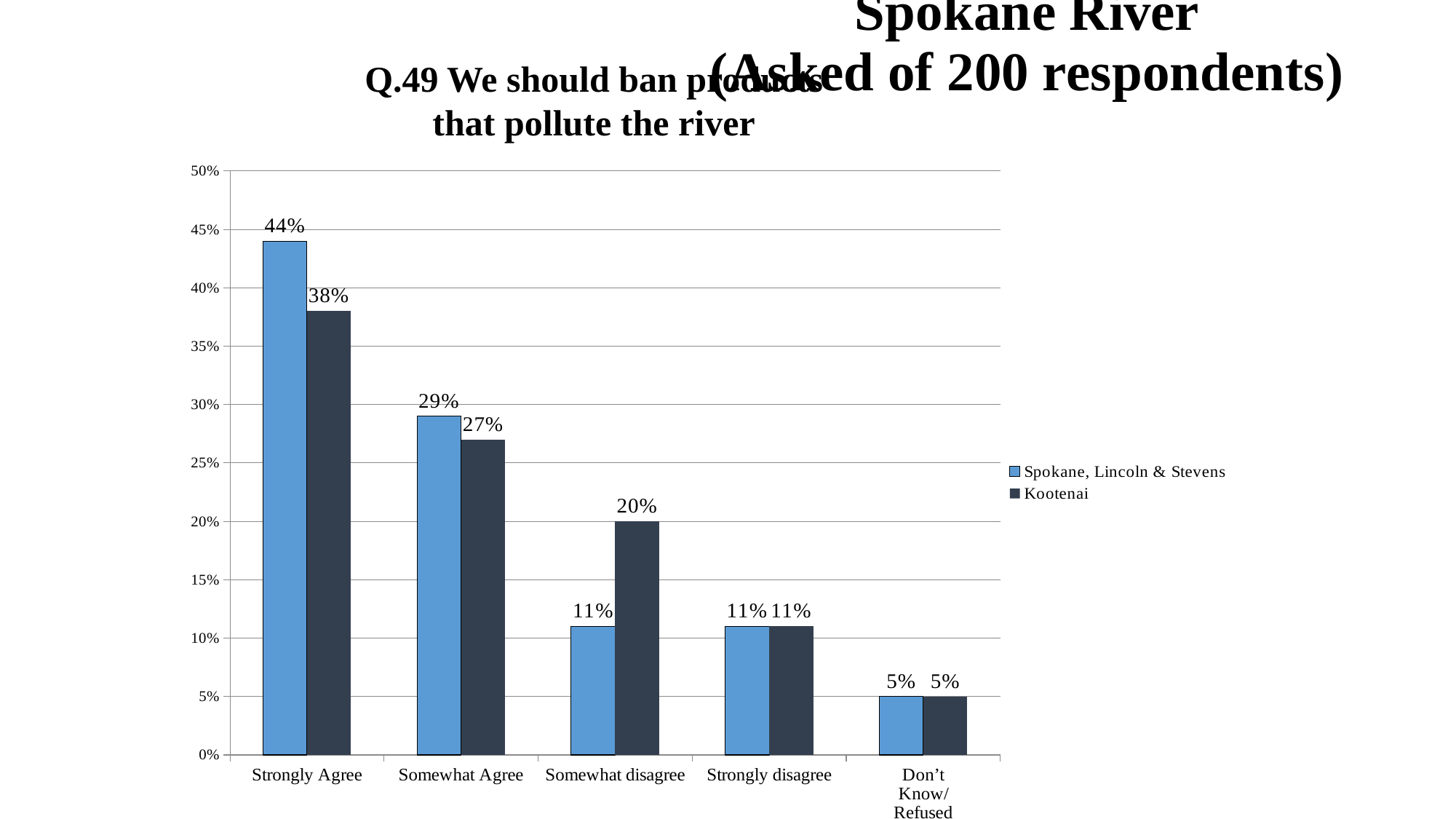
How many categories are shown on the x axis? 5 Do the Spokane, Lincoln & Stevens values rise or fall from Strongly Agree to Don't Know/Refused? Fall What is the value for Kootenai in the Somewhat disagree category? 20% In the Somewhat Agree category, which series has the larger value? Spokane, Lincoln & Stevens What is the value for Spokane, Lincoln & Stevens in the Strongly Agree category? 44% What is the difference between the Spokane, Lincoln & Stevens and Kootenai values in the Strongly Agree category? 6% Which category has the highest value for Kootenai? Strongly Agree How many series does the legend list? 2 What is the difference between the Kootenai and Spokane, Lincoln & Stevens values in the Somewhat disagree category? 9% Which category has the lowest value for Spokane, Lincoln & Stevens? Don't Know/Refused What kind of chart is shown on the slide? Bar chart What is the value for Kootenai in the Somewhat Agree category? 27%